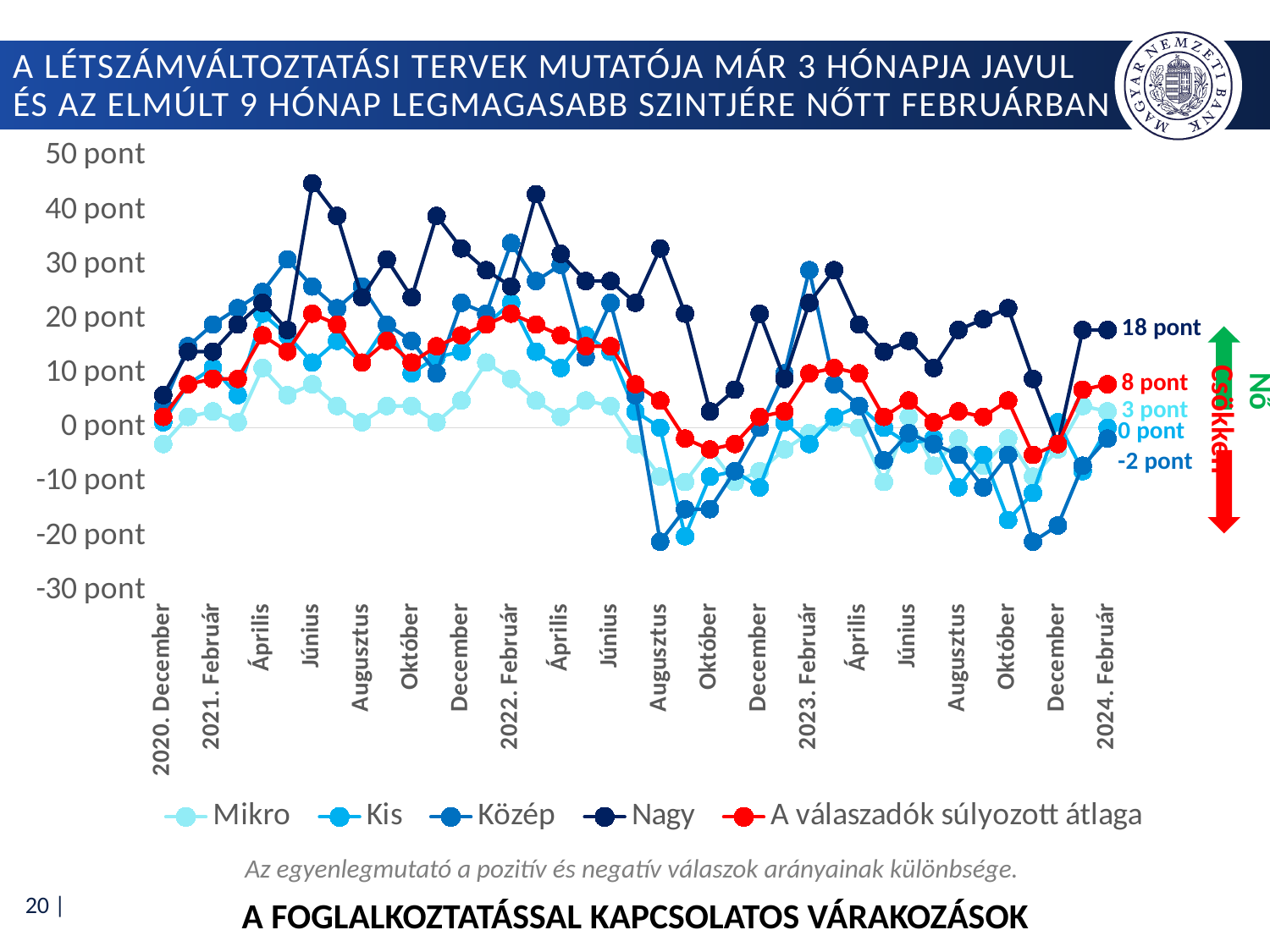
What is the value of the Nagy series in 2024. Február? 18 pont Is the value of the Közép series in 2022. Augusztus greater or less than -10 pont? less Is the value of the Nagy series in 2021. Június greater or less than 40 pont? greater Which series has the lowest value in 2024. Február? Közép What is the value of the Közép series in 2024. Február? -2 pont What is the value of the Mikro series in 2024. Február? 3 pont In 2024. Február, which is larger: the Kis value or the Mikro value? Mikro How many series does the legend list? 5 What kind of chart is shown on the slide? line chart Which series has the highest value in 2024. Február? Nagy What is the value of 'A válaszadók súlyozott átlaga' in 2024. Február? 8 pont What is the difference between the Nagy value and the weighted average ('A válaszadók súlyozott átlaga') in 2024. Február? 10 pont